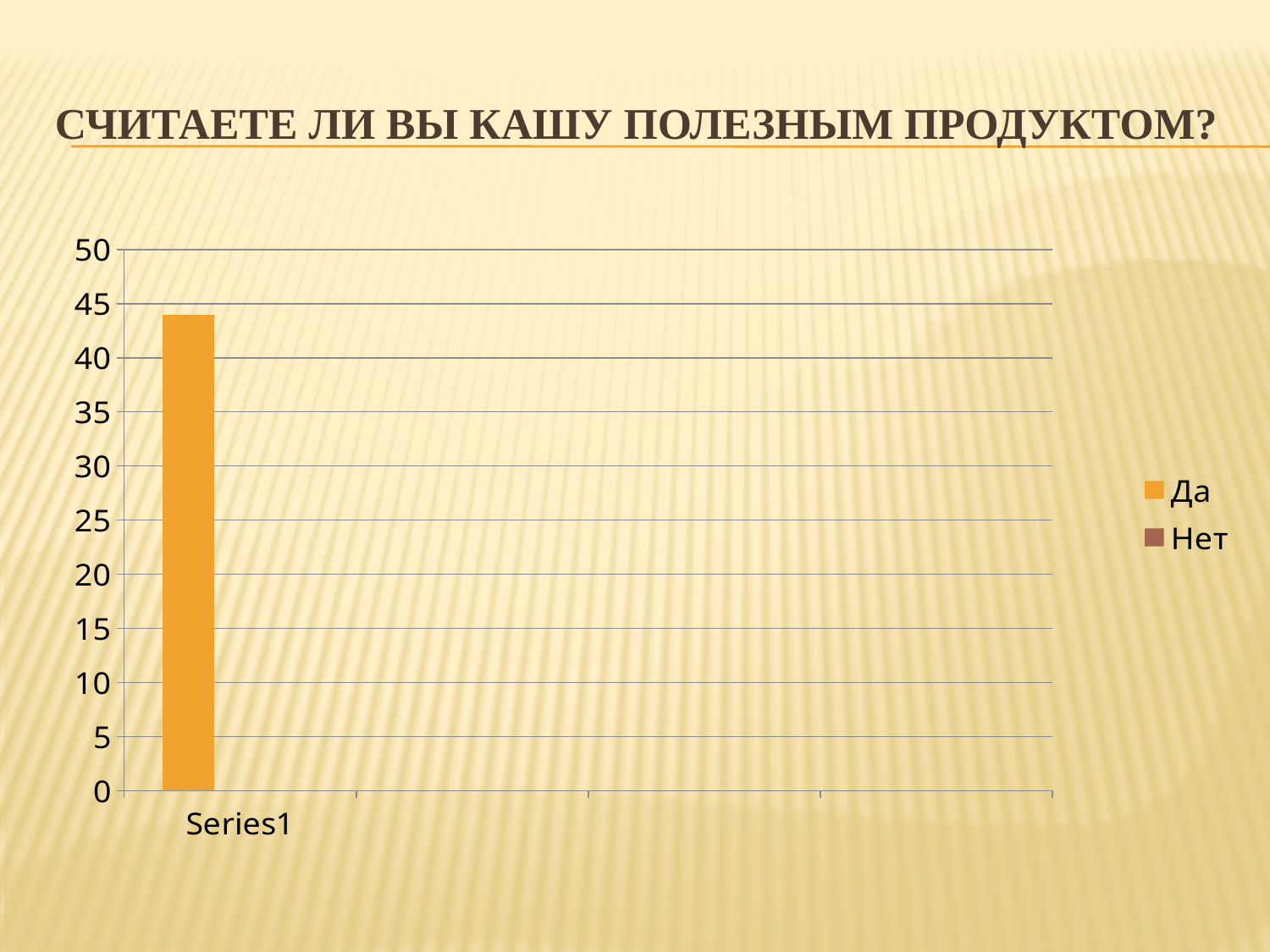
What is the title of the slide above the chart? Считаете ли вы кашу полезным продуктом? Is the value of the Да bar greater or less than 30? greater What is the label of the category on the x axis? Series1 Is the value of the Да bar greater or less than 40? greater Is the value of the Да bar greater or less than 50? less What kind of chart is shown on the slide? bar chart What is the highest value shown on the vertical axis? 50 How many categories are labelled on the x axis? 1 What are the two entries in the chart legend? Да, Нет How many series does the legend list? 2